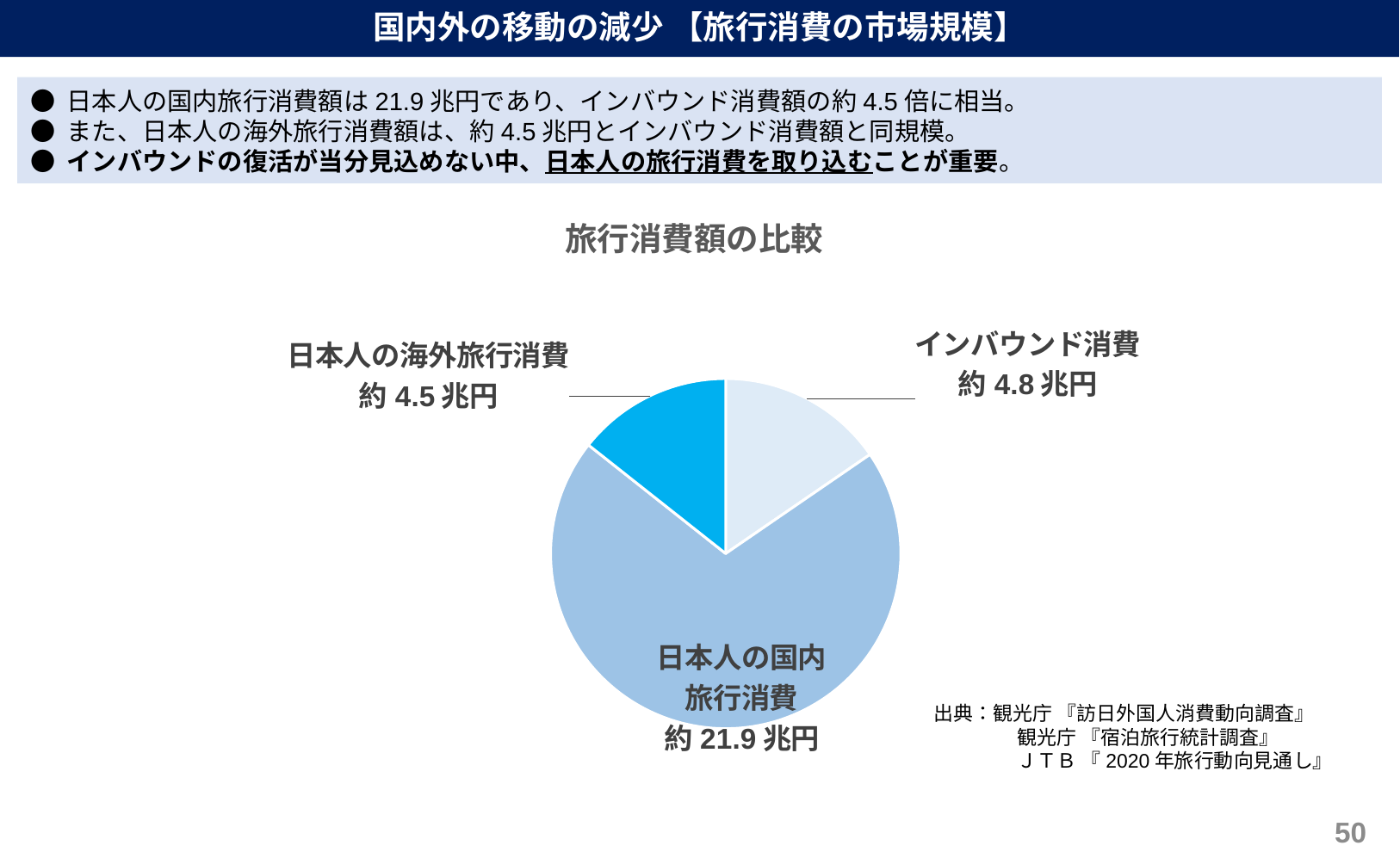
What kind of chart is shown on the slide? Pie chart What is the difference between インバウンド消費 and 日本人の海外旅行消費? 0.3 兆円 Which is larger, インバウンド消費 or 日本人の海外旅行消費? インバウンド消費 Which slice of the pie is coloured bright blue? 日本人の海外旅行消費 What is the title of the chart? 旅行消費額の比較 What value is shown for 日本人の海外旅行消費? 約 4.5 兆円 What value is shown for インバウンド消費? 約 4.8 兆円 How many slices does the pie chart have? 3 Which category has the largest slice of the pie? 日本人の国内旅行消費 Which category has the smallest slice of the pie? 日本人の海外旅行消費 What value is shown for 日本人の国内旅行消費? 約 21.9 兆円 What is the difference between 日本人の国内旅行消費 and インバウンド消費? 17.1 兆円